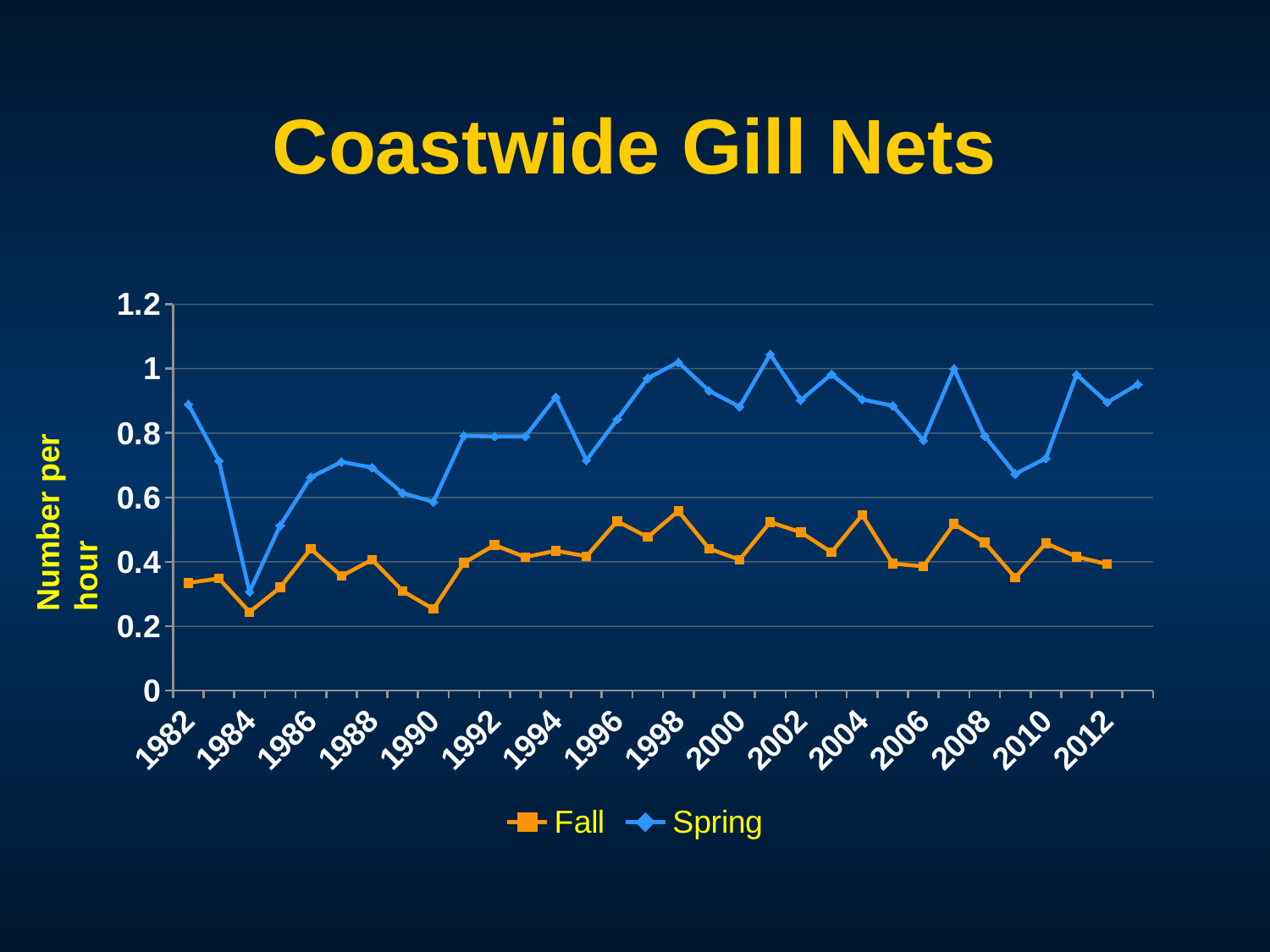
What kind of chart is shown on the slide? line chart Is the Spring value for 1984 greater or less than 0.4? less What is the label on the y axis? Number per hour In 1982, which series has the higher value, Fall or Spring? Spring In which year is the Spring series at its lowest? 1984 How many series does the legend list? 2 Is the Fall value for 1998 greater or less than 0.6? less Is the Spring value for 2009 greater or less than 0.8? less Does the Spring series rise or fall from 1982 to 1984? fall What is the title of the chart? Coastwide Gill Nets